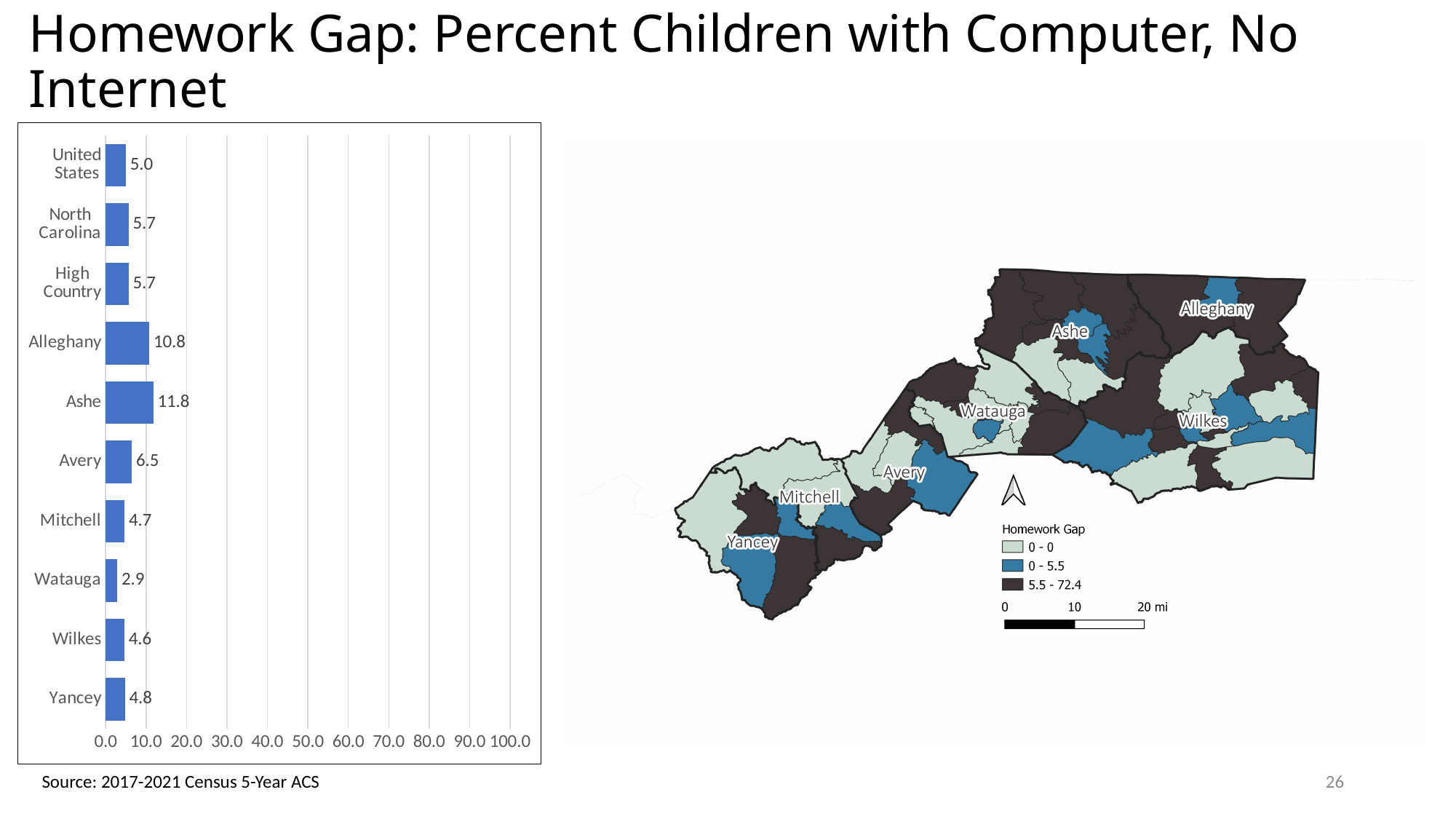
Is the value for Alleghany in the bar chart greater or less than 10.0? greater What is the difference between the values for Ashe and Alleghany in the bar chart? 1.0 What is the value for the United States in the bar chart? 5.0 Which category has the lowest value in the bar chart? Watauga Which has a larger value in the bar chart, Avery or Mitchell? Avery How many categories are shown in the bar chart? 10 What is the maximum value shown on the x axis of the bar chart? 100.0 What kind of chart is shown on the left of the slide? Bar chart What is the value for Ashe in the bar chart? 11.8 What is the value for North Carolina in the bar chart? 5.7 What is the value for Watauga in the bar chart? 2.9 Which category has the highest value in the bar chart? Ashe